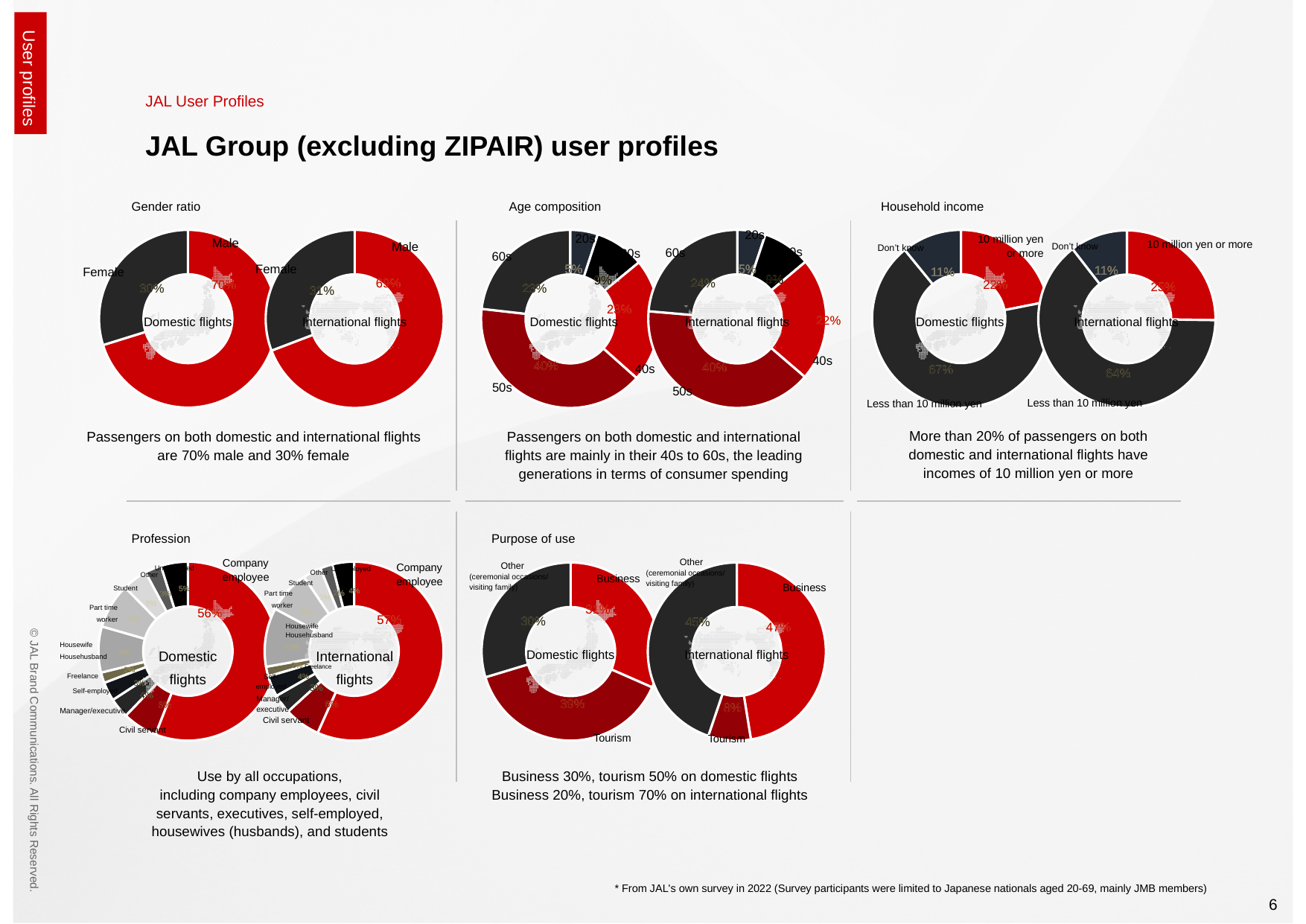
What type of chart is used for the Gender ratio section? Doughnut (pie) chart In the Household income chart for Domestic flights, what share of passengers have incomes of less than 10 million yen? 67% In the Household income chart for International flights, what share of passengers answered 'Don't know'? 11% How many income categories are shown in the Household income chart for Domestic flights? 3 In the Gender ratio chart for Domestic flights, which is larger, the male share or the female share? Male In the Gender ratio chart for Domestic flights, what percentage of passengers are male? 70% In the Age composition chart for International flights, what share of passengers are in their 50s? 40% In the Profession chart for Domestic flights, what share of passengers are company employees? 56% In the Household income chart for Domestic flights, what is the difference between the 'Less than 10 million yen' share and the '10 million yen or more' share? 45 percentage points In the Gender ratio chart for International flights, what percentage of passengers are female? 31% In the Age composition chart for Domestic flights, which age group has the largest share? 50s In the Household income chart for International flights, what share of passengers have incomes of 10 million yen or more? 25%